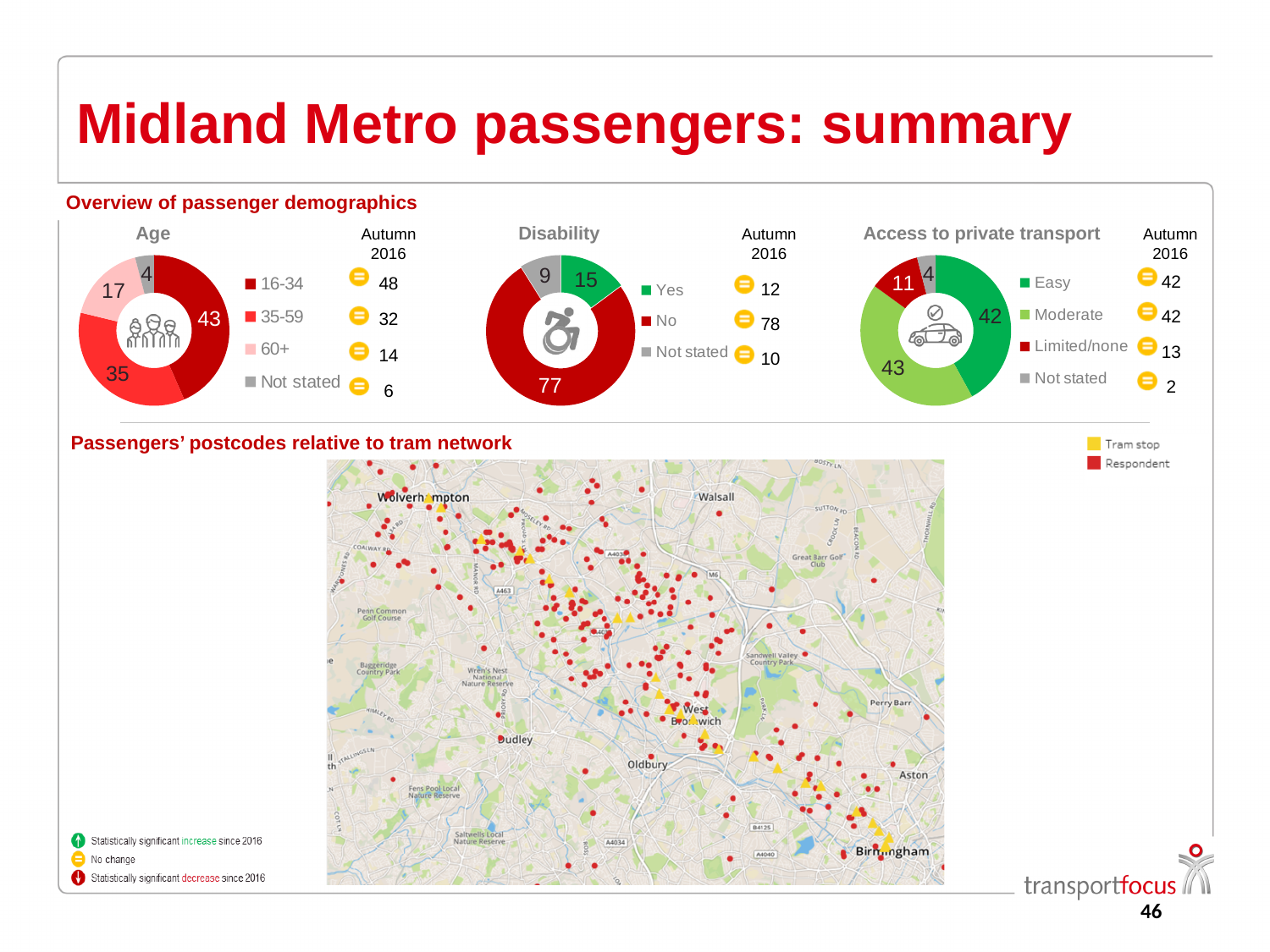
In the Disability chart, how many categories does the legend list? 3 In the Age chart, what is the difference between the 16-34 and 35-59 values? 8 In the Disability chart, which category has the lowest value? Not stated In the Age chart, what is the value for the 16-34 category? 43 What kind of chart is used for the Age, Disability and Access to private transport data? Donut (pie) chart In the Age chart, what is the value for the 60+ category? 17 In the Disability chart, what is the value for No? 77 In the Age chart, what was the Autumn 2016 value for the 16-34 category? 48 In the Age chart, which category has the highest value? 16-34 In the Access to private transport chart, which category has the lowest value? Not stated In the Access to private transport chart, is the value for Moderate larger or smaller than the value for Limited/none? larger In the Access to private transport chart, what is the value for Limited/none? 11